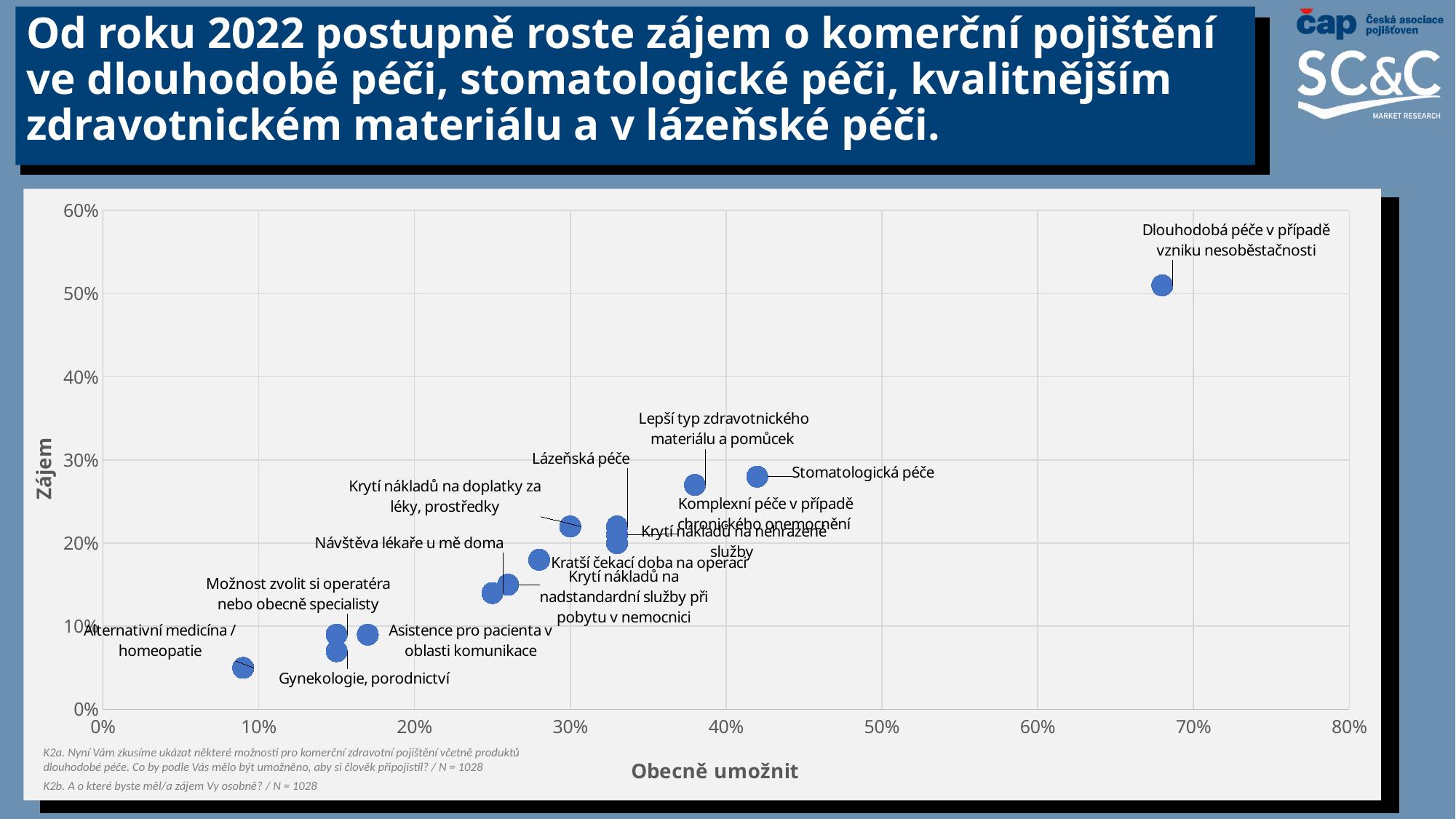
What kind of chart is shown on the slide? scatter chart Is the Zájem value for Dlouhodobá péče v případě vzniku nesoběstačnosti greater or less than 40%? greater Which item has the highest value on the Zájem (vertical) axis? Dlouhodobá péče v případě vzniku nesoběstačnosti Is the Obecně umožnit value for Stomatologická péče greater or less than 40%? greater Is the Zájem value for Alternativní medicína / homeopatie greater or less than 10%? less Which item has the lowest value on the Zájem (vertical) axis? Alternativní medicína / homeopatie Which has the higher Zájem value: Stomatologická péče or Dlouhodobá péče v případě vzniku nesoběstačnosti? Dlouhodobá péče v případě vzniku nesoběstačnosti What is the label of the horizontal axis of the chart? Obecně umožnit Which item has the highest value on the Obecně umožnit (horizontal) axis? Dlouhodobá péče v případě vzniku nesoběstačnosti Which has the higher Obecně umožnit value: Alternativní medicína / homeopatie or Asistence pro pacienta v oblasti komunikace? Asistence pro pacienta v oblasti komunikace